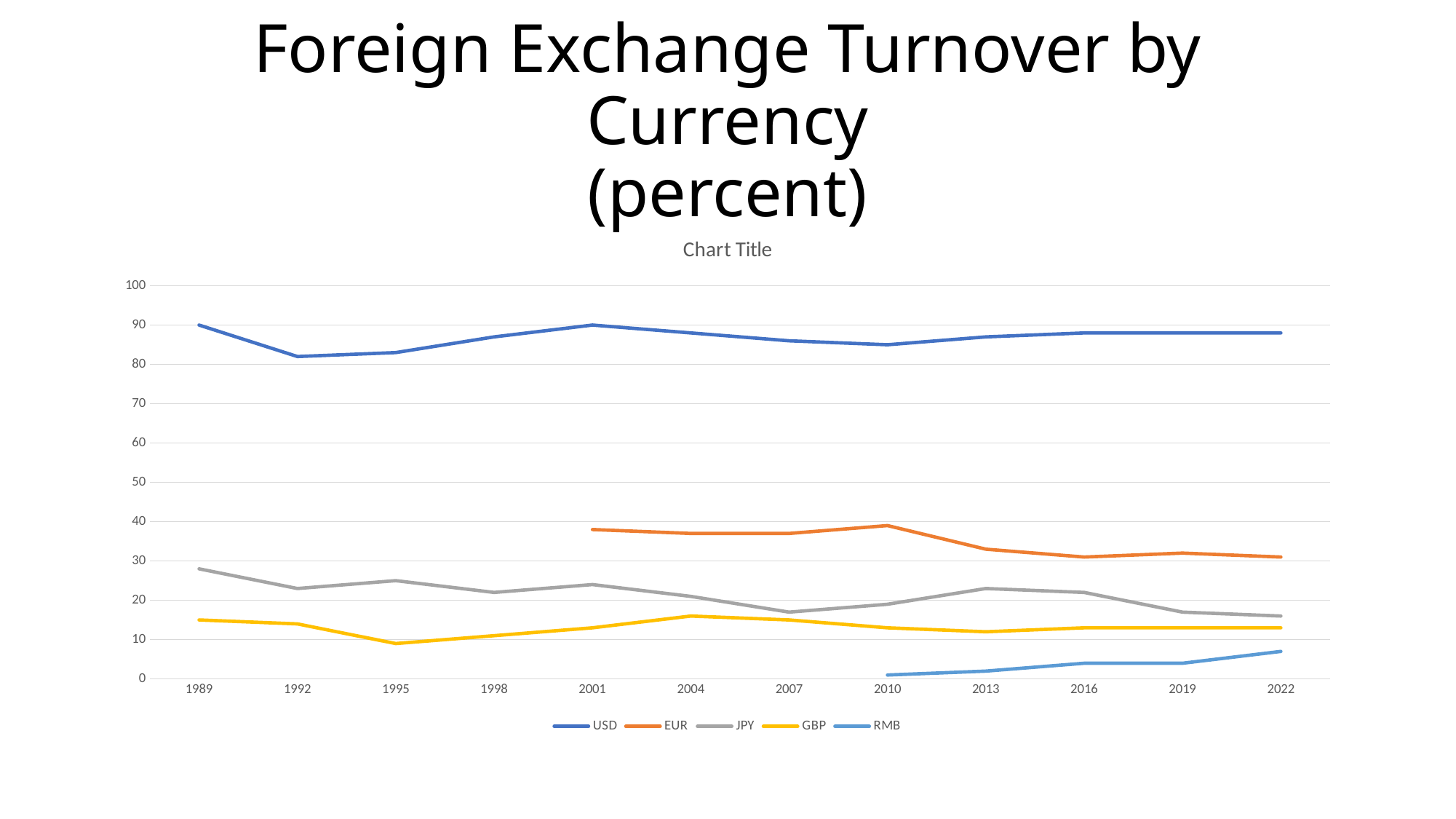
Is the value for USD in 1992 greater or less than 90? less Which currency has the highest turnover share in 2022? USD Is the value for EUR in 2010 greater or less than 30? greater What kind of chart is shown on the slide? line chart In 2010, which is larger, the value for EUR or the value for JPY? EUR How many years are plotted along the x axis? 12 Which currency has the lowest turnover share in 2022? RMB Which series is drawn in orange in the legend? EUR Is the value for RMB in 2022 greater or less than 10? less How many series does the legend list? 5 Does the RMB line rise or fall from 2010 to 2022? rise